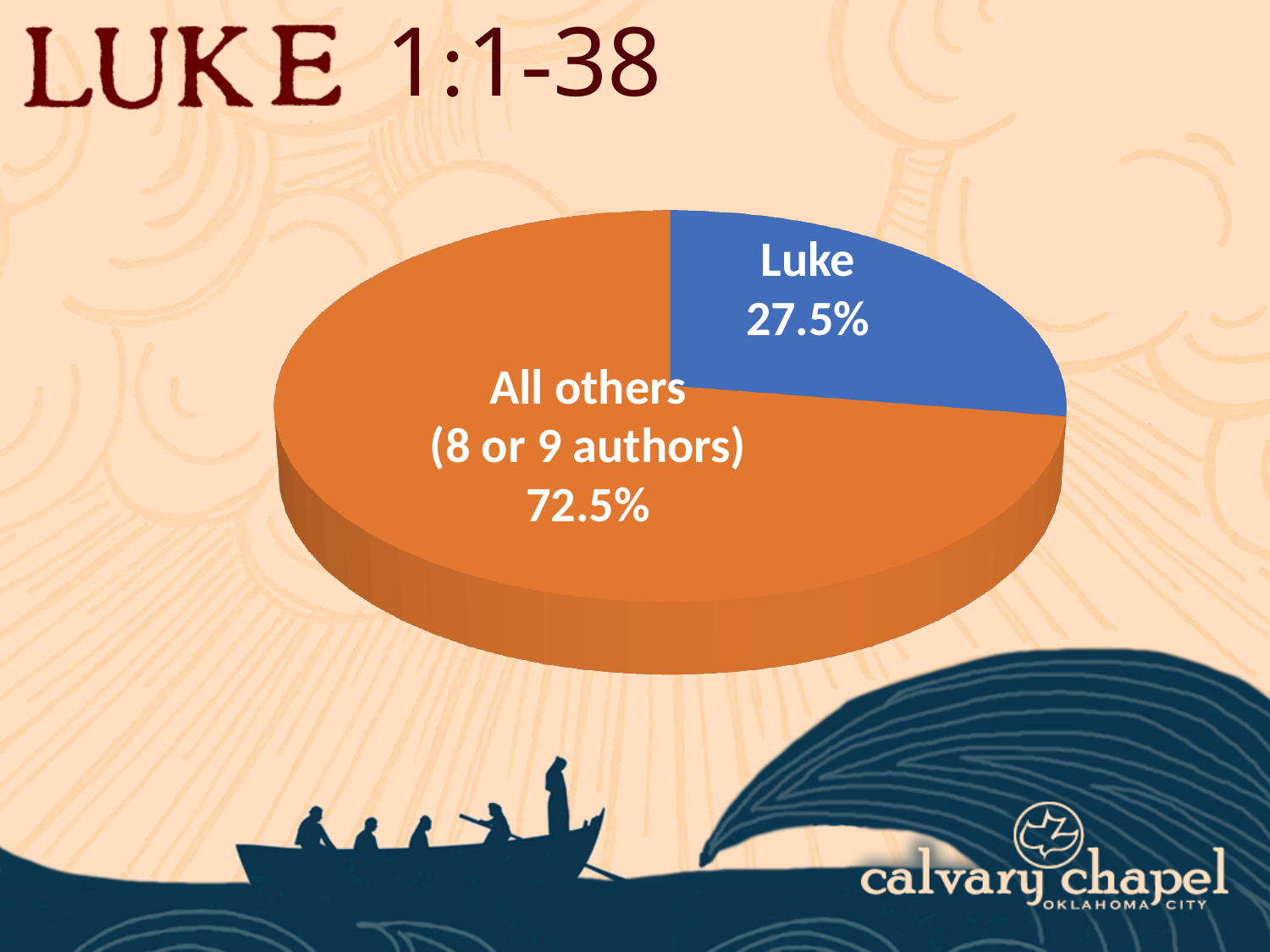
What share of the pie does Luke account for? 27.5% What kind of chart is shown on the slide? Pie chart What do the two slices of the pie add up to? 100% Which slice of the pie is the smallest? Luke What is the difference in percentage points between the All others slice and the Luke slice? 45 percentage points Which is larger, the Luke slice or the All others slice? All others Is the value for Luke greater or less than 50%? less What share of the pie does All others (8 or 9 authors) account for? 72.5% What colour is the Luke slice? Blue How many slices does the pie chart have? 2 What colour is the All others (8 or 9 authors) slice? Orange Which slice of the pie is the largest? All others (8 or 9 authors)